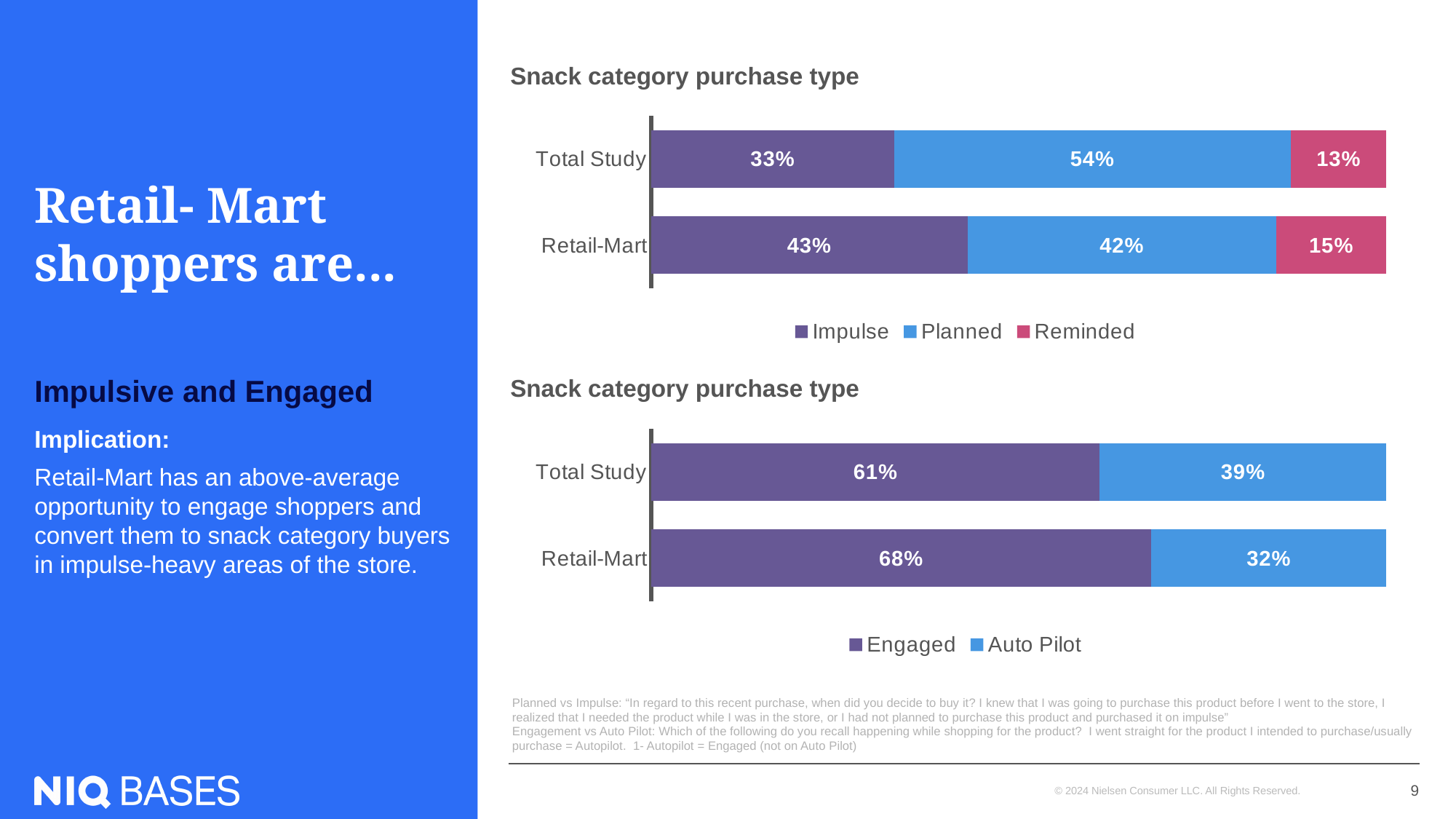
In the bottom chart, which category has the higher Auto Pilot value? Total Study In the top chart, what is the Reminded value for Retail-Mart? 15% What type of chart is the bottom chart? Stacked bar chart How many series does the legend of the top chart list? 3 In the top chart, what is the Impulse value for Retail-Mart? 43% In the top chart, which segment is smallest for Total Study? Reminded In the bottom chart, what is the Auto Pilot value for Total Study? 39% In the top chart, what is the Planned value for Total Study? 54% In the top chart, what is the difference between the Impulse values for Retail-Mart and Total Study? 10% In the top chart, which is larger for Total Study: Impulse or Planned? Planned In the bottom chart, what is the difference between the Engaged values for Retail-Mart and Total Study? 7% In the bottom chart, what is the Engaged value for Retail-Mart? 68%